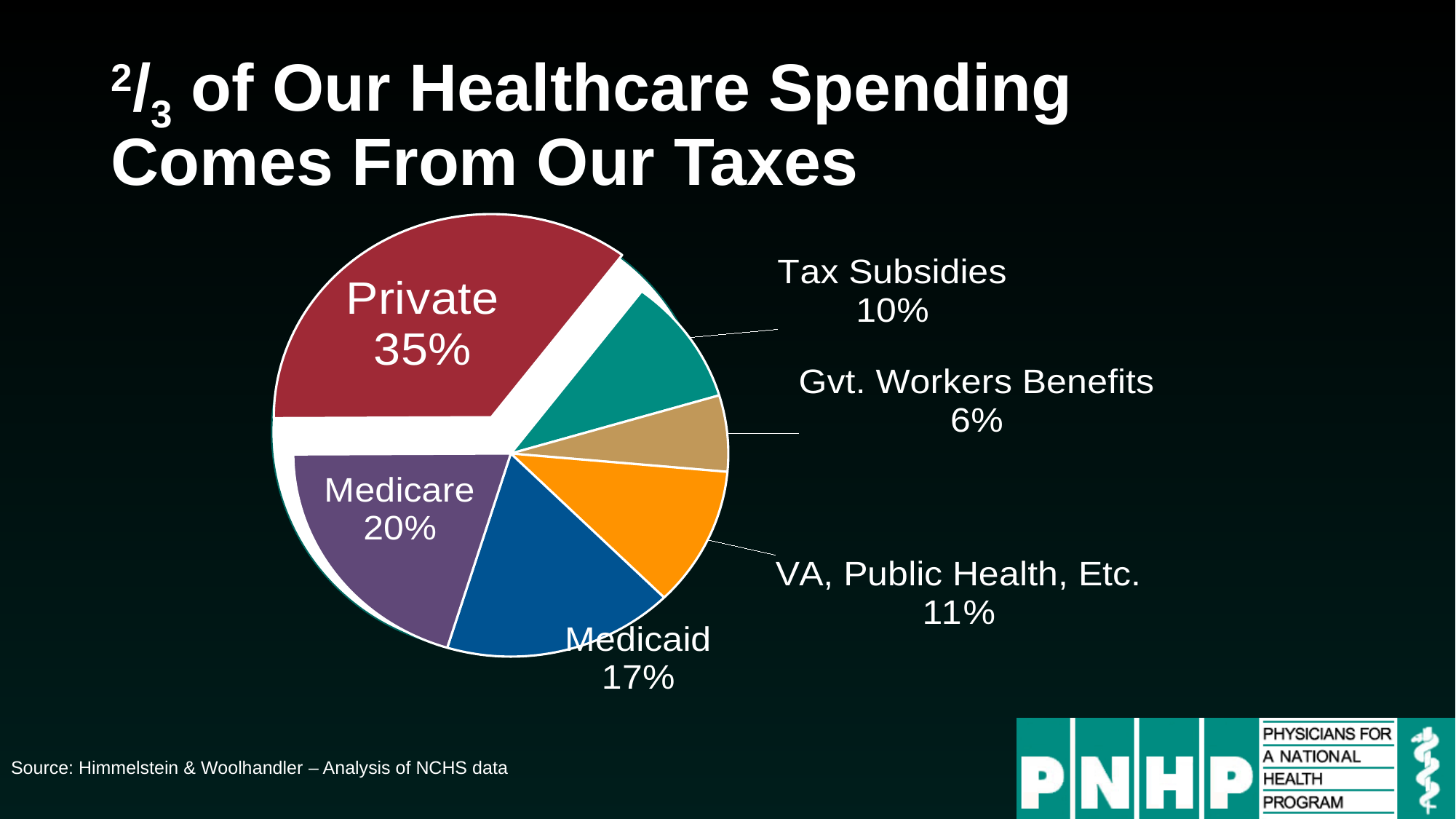
Which is larger, Medicaid or VA, Public Health, Etc.? Medicaid What share of healthcare spending is labelled as Private? 35% What percentage is shown for Medicare? 20% What kind of chart is shown on the slide? Pie chart Which slice of the pie is the largest? Private What percentage is shown for Tax Subsidies? 10% How many slices does the pie chart have? 6 What percentage is shown for Medicaid? 17% What percentage is shown for Gvt. Workers Benefits? 6% What is the difference in percentage points between Private and Medicare? 15 Which slice of the pie is the smallest? Gvt. Workers Benefits What percentage is shown for VA, Public Health, Etc.? 11%